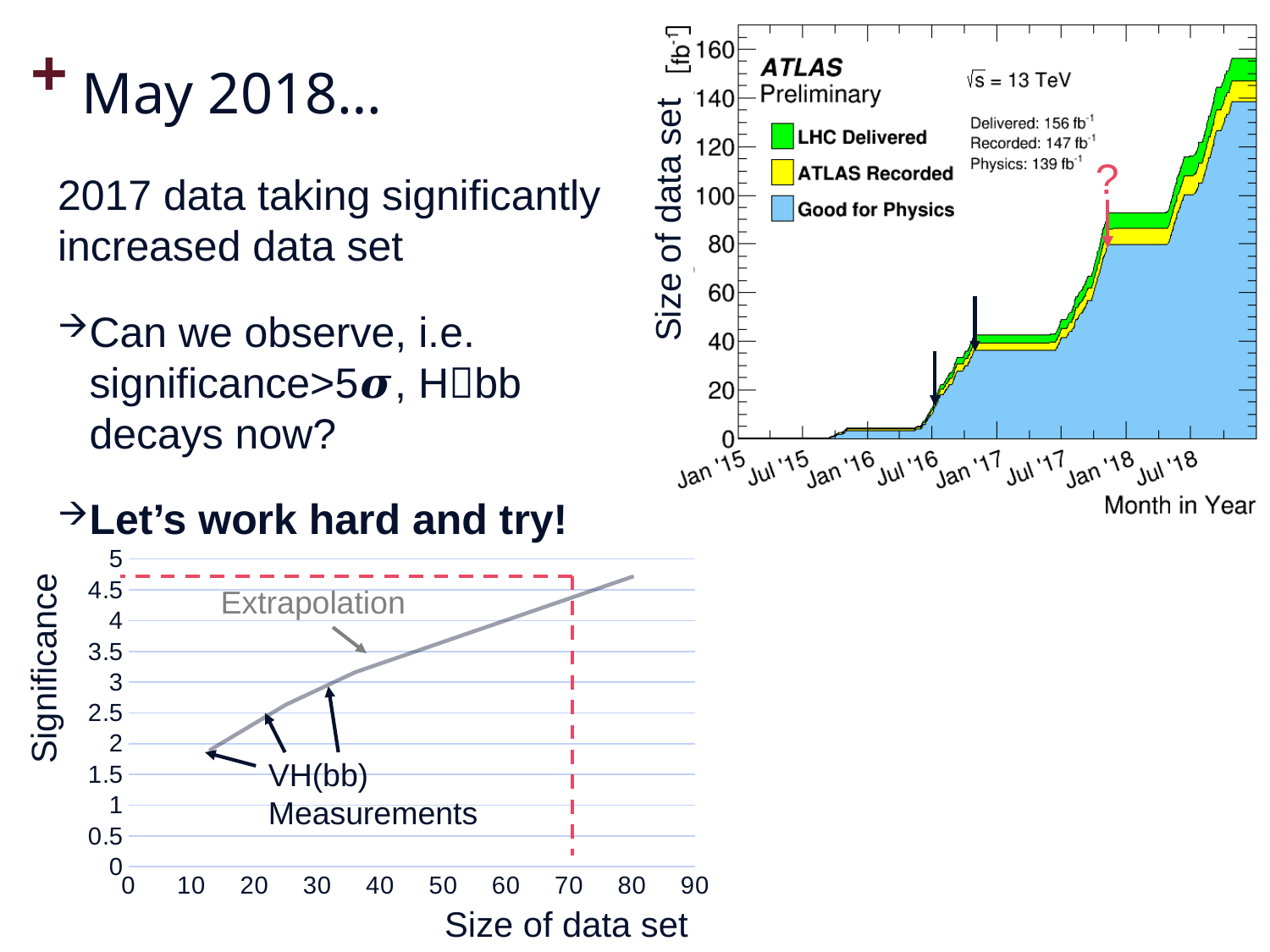
In the ATLAS chart on the top right, what is the Physics value printed on the chart? 139 fb⁻¹ In the ATLAS chart on the top right, which is larger, the Recorded value or the Physics value? Recorded In the ATLAS chart on the top right, which legend entry is shown in blue? Good for Physics In the ATLAS chart on the top right, what is the label of the x axis? Month in Year In the Significance chart on the bottom left, does significance rise or fall as the size of the data set increases? rise In the ATLAS chart on the top right, does the size of the data set rise or fall from Jan '15 to Jul '18? rise In the ATLAS chart on the top right, what is the Delivered value printed on the chart? 156 fb⁻¹ In the Significance chart on the bottom left, is the significance at a data set size of 70 greater or less than 5? less In the ATLAS chart on the top right, what is the difference between the Delivered and Recorded values? 9 fb⁻¹ In the ATLAS chart on the top right, what is the Recorded value printed on the chart? 147 fb⁻¹ In the ATLAS chart on the top right, how many entries does the legend list? 3 In the Significance chart on the bottom left, what kind of chart is it? line chart